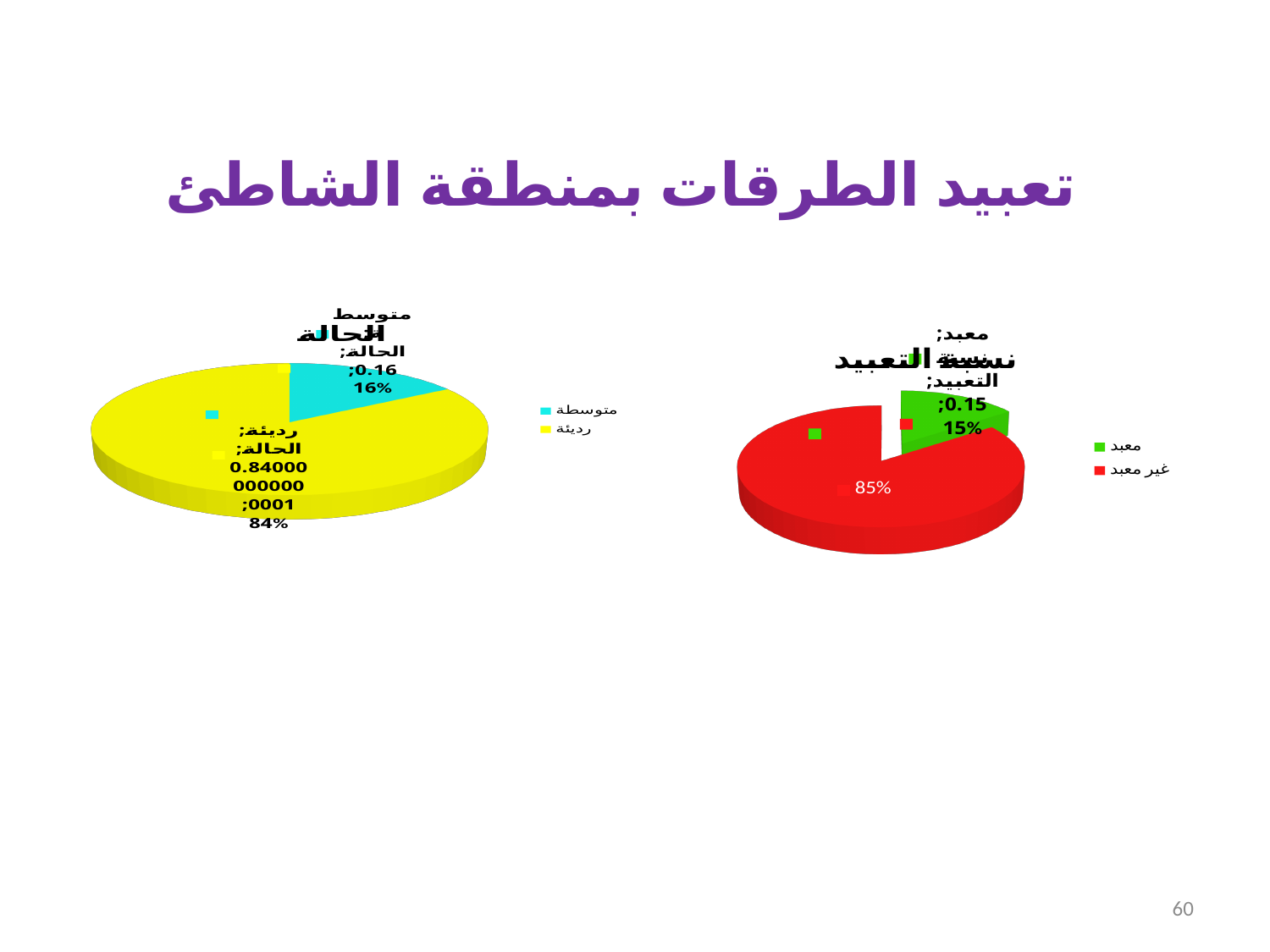
In the right pie chart, what percentage share does the غير معبد slice have? 85% In the left pie chart, which category has the largest slice? رديئة In the right pie chart, which category has the largest slice? غير معبد In the left pie chart, what colour is the رديئة slice? yellow In the left pie chart, what percentage share does the رديئة slice have? 84% In the left pie chart, what percentage share does the متوسطة slice have? 16% How many entries does the legend of the right pie chart list? 2 What kind of chart is the chart on the right of the slide? pie chart In the left pie chart, which category has the smallest slice? متوسطة What kind of chart is the chart on the left of the slide? pie chart In the right pie chart, what is the difference in percentage points between the غير معبد and معبد slices? 70